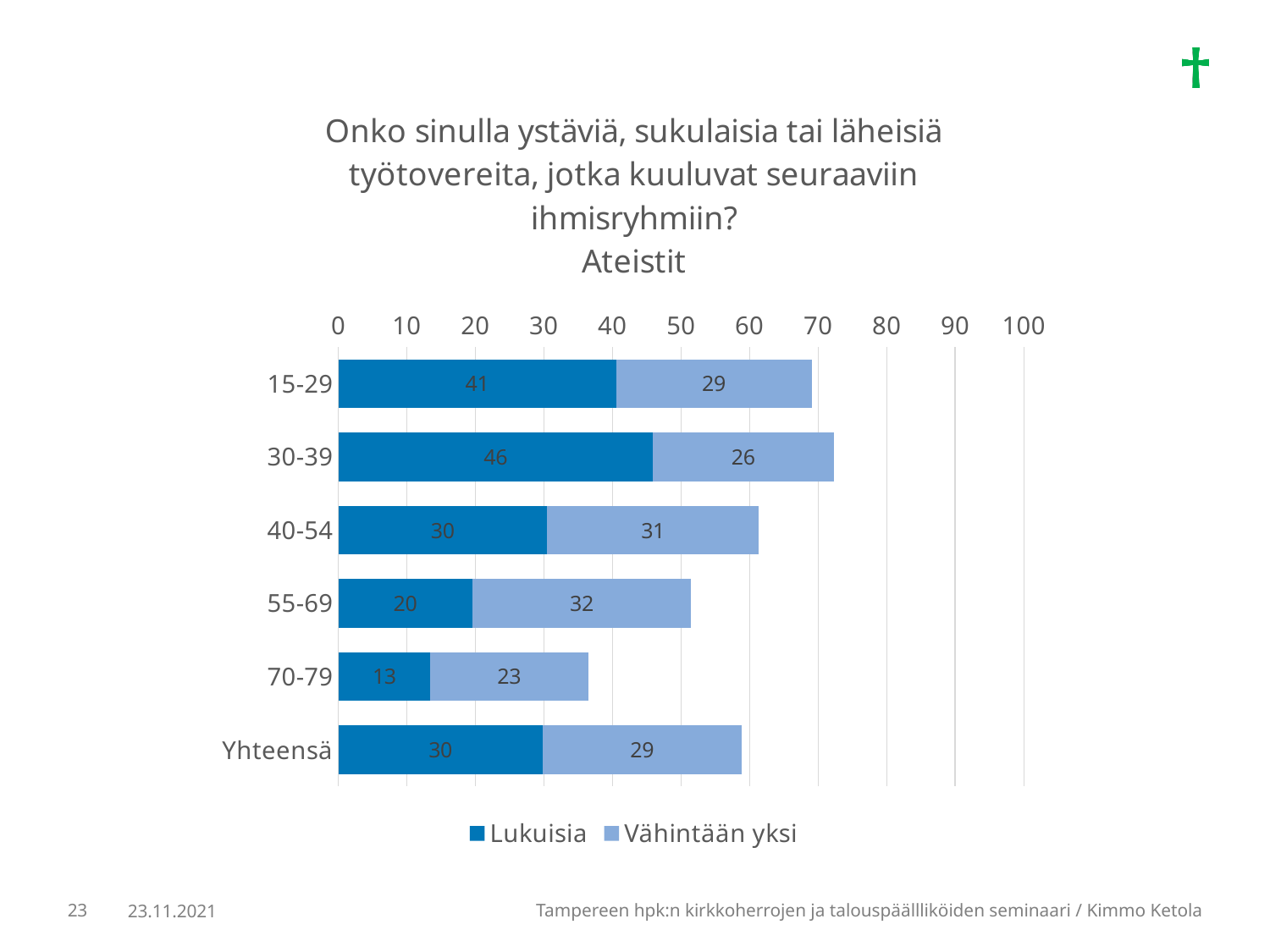
What is the total of the stacked bar for the 30-39 age group? 72 What kind of chart is shown on the slide? Stacked bar chart How many series does the legend list? 2 Which is larger: the "Lukuisia" value for 40-54 or the "Lukuisia" value for 55-69? 40-54 Which age group has the highest "Lukuisia" value? 30-39 Which category has the lowest "Vähintään yksi" value? 70-79 How many categories are shown on the vertical axis? 6 What is the value of "Lukuisia" for Yhteensä? 30 What is the value of "Lukuisia" for the 30-39 age group? 46 What is the difference between the "Lukuisia" values for 15-29 and 70-79? 28 What is the total of the stacked bar for the 70-79 age group? 36 What is the value of "Vähintään yksi" for the 55-69 age group? 32